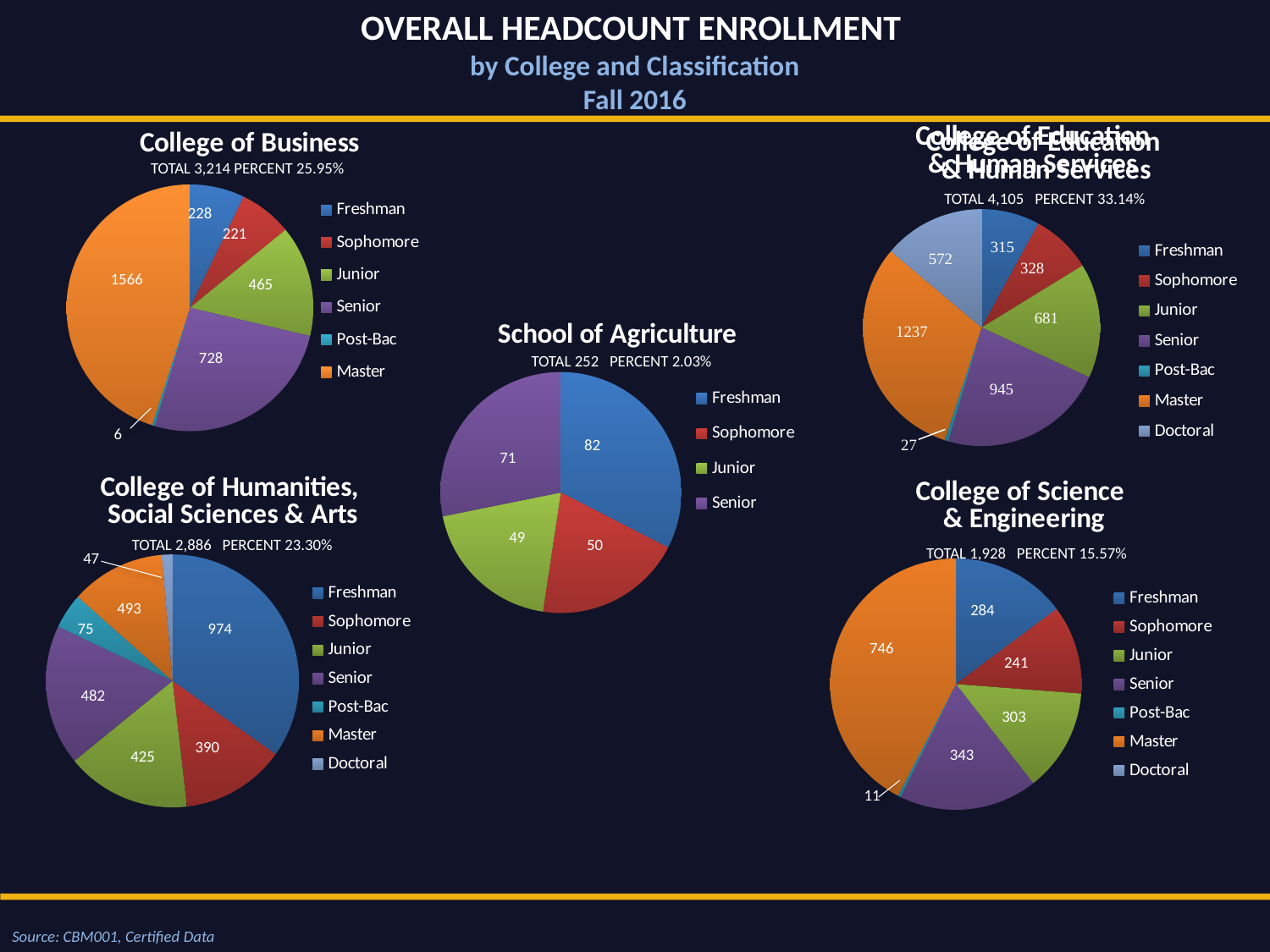
In the College of Business chart, which classification has the smallest slice? Post-Bac In the School of Agriculture chart, which classification has the largest slice? Freshman In the College of Humanities, Social Sciences & Arts chart, which is larger: Master or Senior? Master What percent of overall enrollment does the School of Agriculture chart report? 2.03% In the College of Humanities, Social Sciences & Arts chart, what is the value for Doctoral? 47 What type of chart is used for the College of Science & Engineering? Pie chart In the College of Business chart, how many students are Master's students? 1566 How many classifications does the legend of the School of Agriculture chart list? 4 In the College of Science & Engineering chart, what is the value for Post-Bac? 11 How many pie charts are shown on the slide? 5 What total enrollment is shown for the College of Education & Human Services? 4,105 In the College of Education & Human Services chart, what is the difference between the Senior and Junior values? 264